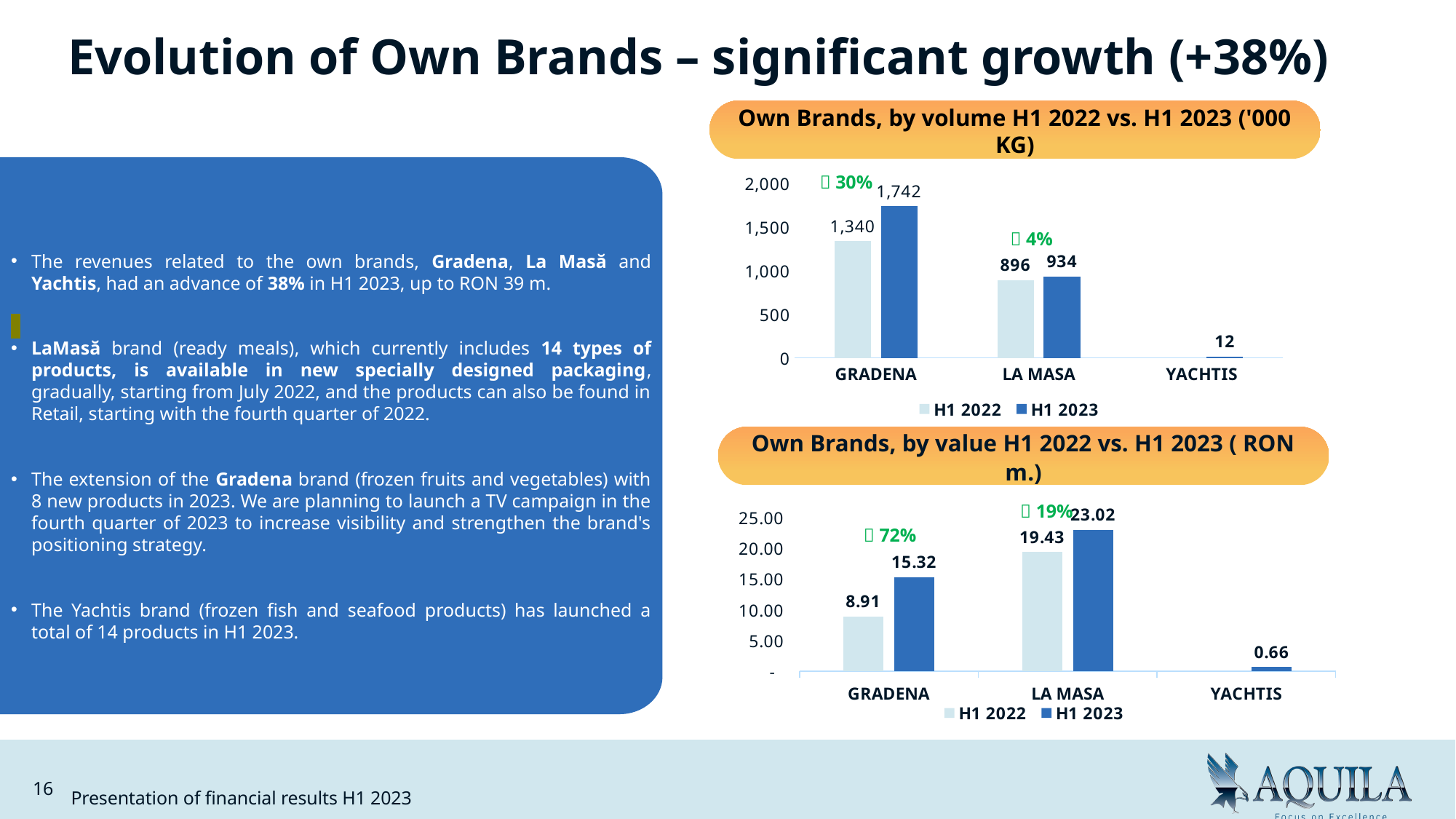
In the 'Own Brands, by value' chart, which brand has the lowest H1 2023 value? YACHTIS In the 'Own Brands, by volume' chart, what is the difference between the H1 2023 and H1 2022 values for GRADENA? 402 In the 'Own Brands, by value' chart, what is the H1 2023 value for YACHTIS? 0.66 In the 'Own Brands, by volume' chart, what is the H1 2023 value for GRADENA? 1,742 In the 'Own Brands, by volume' chart, how many series does the legend list? 2 In the 'Own Brands, by value' chart, what is the H1 2023 value for LA MASA? 23.02 In the 'Own Brands, by value' chart, is the H1 2023 value for GRADENA or LA MASA larger? LA MASA In the 'Own Brands, by value' chart, what is the H1 2022 value for GRADENA? 8.91 In the 'Own Brands, by volume' chart, what percentage growth is shown above the LA MASA bars? 4% In the 'Own Brands, by volume' chart, which brand has the highest H1 2023 volume? GRADENA In the 'Own Brands, by volume' chart, what is the H1 2022 value for LA MASA? 896 What type of chart is the 'Own Brands, by value' chart? Bar chart